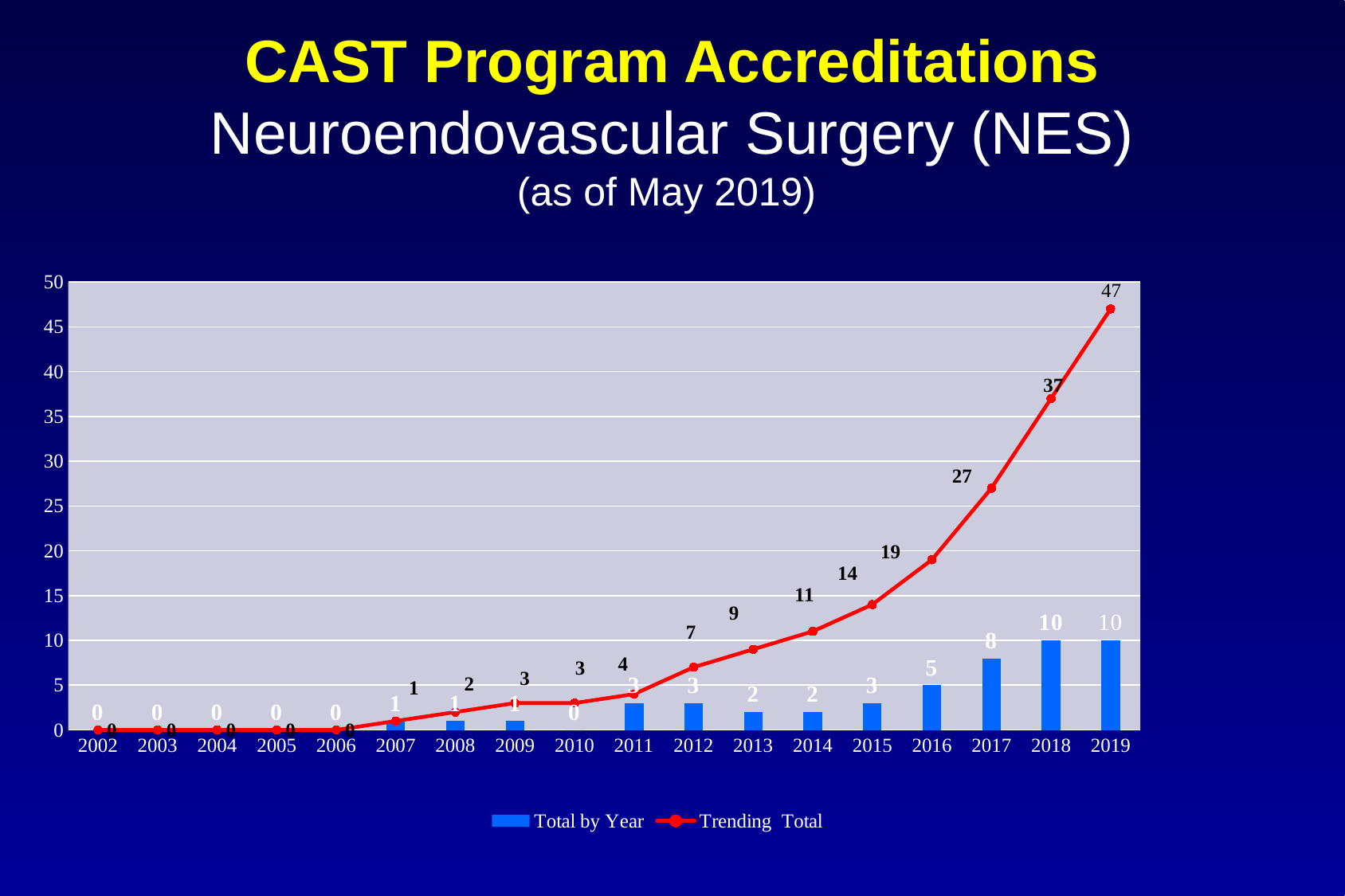
What is the Total by Year value for 2016? 5 What is the Trending Total value for 2015? 14 Is the Trending Total for 2016 greater or less than 15? greater What is the Trending Total value for 2019? 47 Does the Trending Total rise or fall from 2011 to 2019? rise What is the difference between the Trending Total for 2018 and for 2017? 10 What is the Total by Year value for 2017? 8 Which is larger, the Total by Year for 2017 or for 2016? 2017 How many series does the legend list? 2 How many years are shown on the x axis? 18 What colour is the Trending Total line? Red Which year has the highest Trending Total? 2019